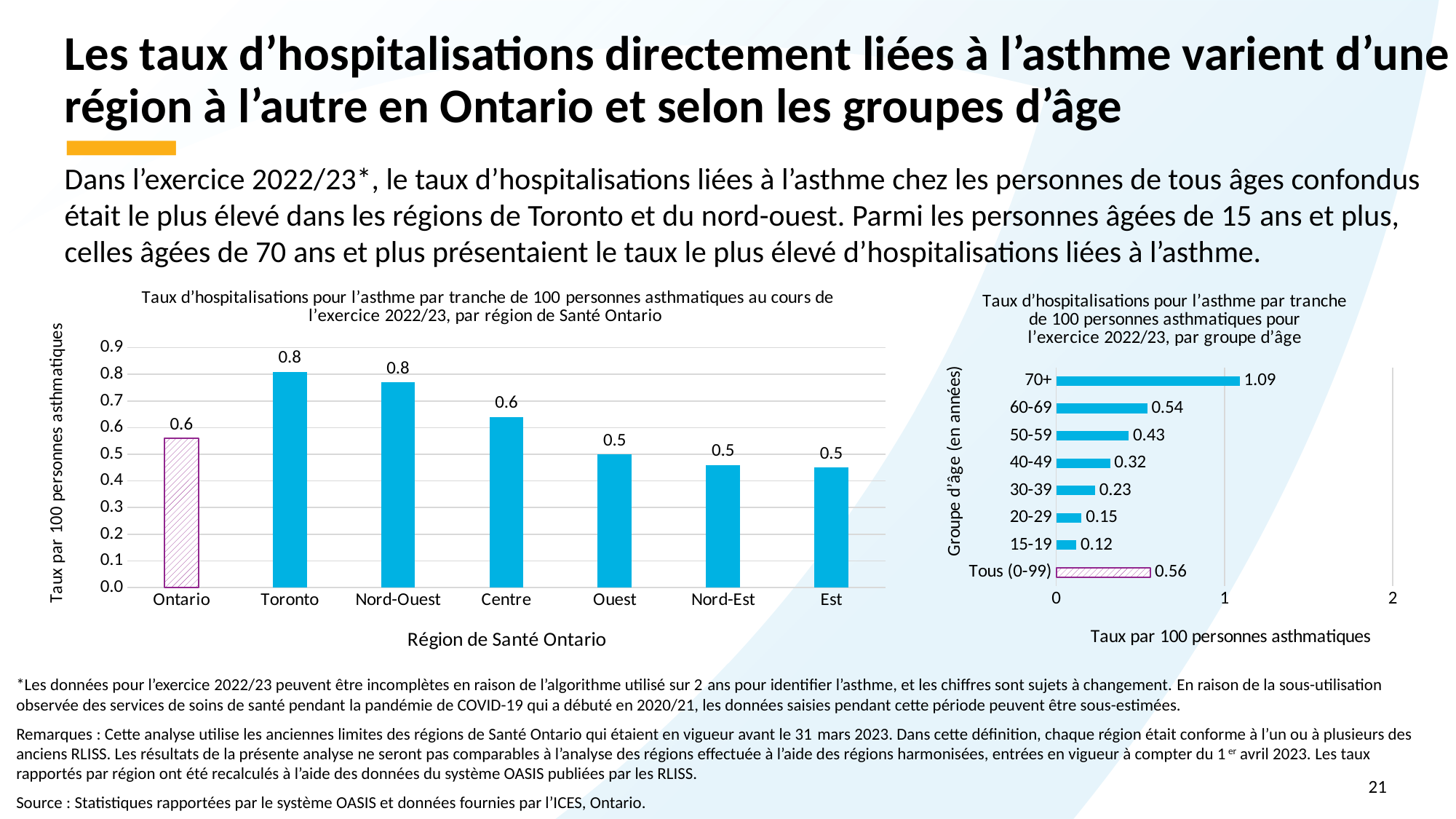
In the chart by region (left), which is larger, the value for Toronto or the value for Ouest? Toronto In the chart by age group (right), which age group has the lowest rate? 15-19 What kind of chart is the chart by region on the left? Bar chart In the chart by age group (right), which age group has the highest rate? 70+ In the chart by region (left), is the value for Toronto greater or less than 0.7? greater In the chart by age group (right), how many age-group categories are shown? 8 In the chart by age group (right), what is the rate for the 70+ group? 1.09 In the chart by age group (right), what is the rate for Tous (0-99)? 0.56 In the chart by region (left), what is the labelled value for Centre? 0.6 In the chart by region (left), what is the labelled hospitalisation rate for Toronto? 0.8 In the chart by region (left), how many regions are shown on the x axis? 7 In the chart by age group (right), what is the difference between the rates for 70+ and 15-19? 0.97